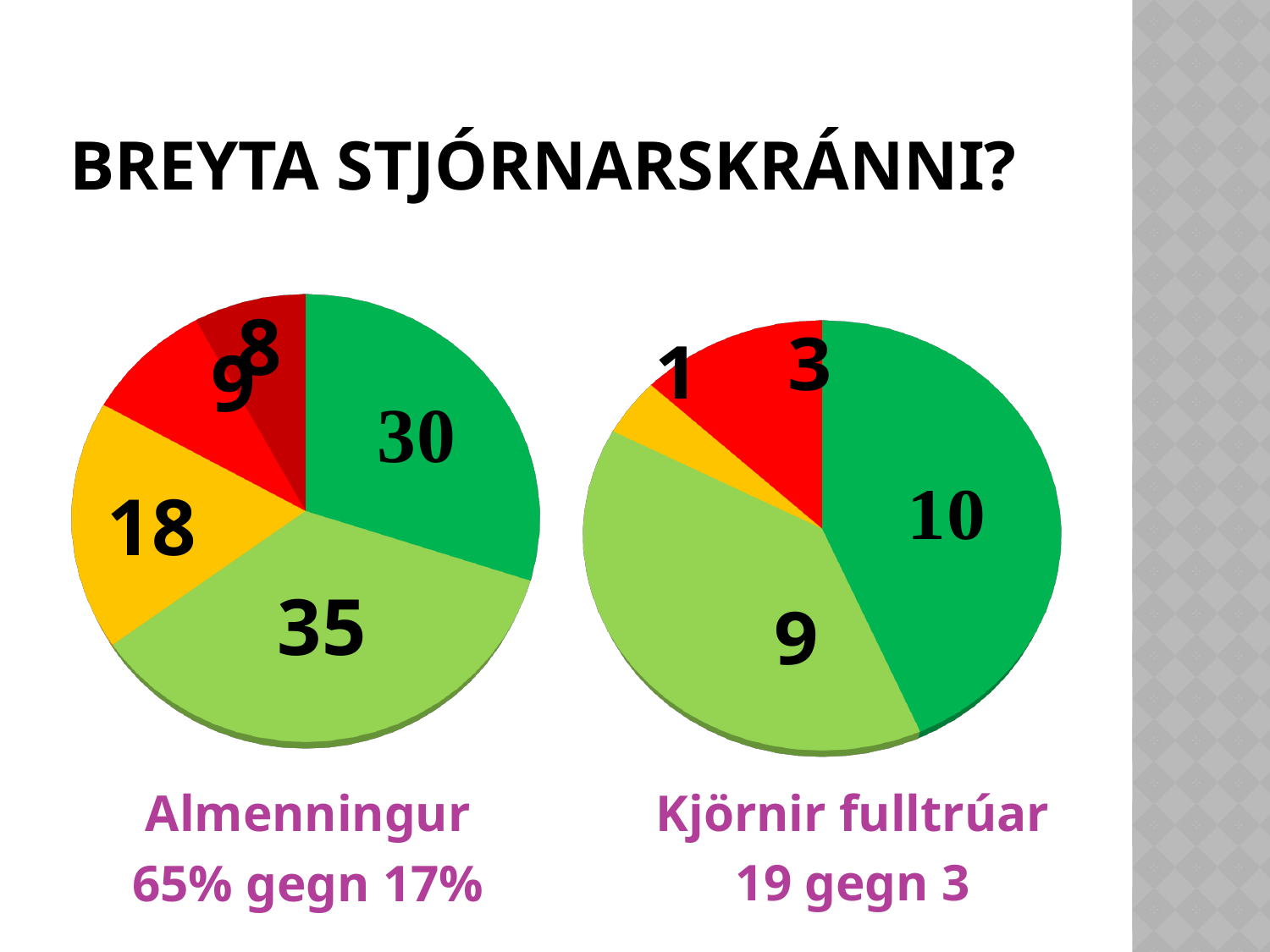
How many slices does the Almenningur pie chart have? 5 In the Almenningur pie chart, what is the difference between the light green slice and the dark green slice? 5 In the Almenningur pie chart, which colour slice has the largest value? light green What type of chart is used for Almenningur? pie chart In the Almenningur pie chart, what value is shown for the light green slice? 35 In the Kjörnir fulltrúar pie chart, which colour slice has the smallest value? yellow In the Kjörnir fulltrúar pie chart, what value is shown for the dark green slice? 10 In the Kjörnir fulltrúar pie chart, which is larger, the red slice or the yellow slice? red In the Almenningur pie chart, what value is shown for the yellow slice? 18 What is the total of all slices in the Kjörnir fulltrúar pie chart? 23 In the Kjörnir fulltrúar pie chart, what value is shown for the yellow slice? 1 How many slices does the Kjörnir fulltrúar pie chart have? 4